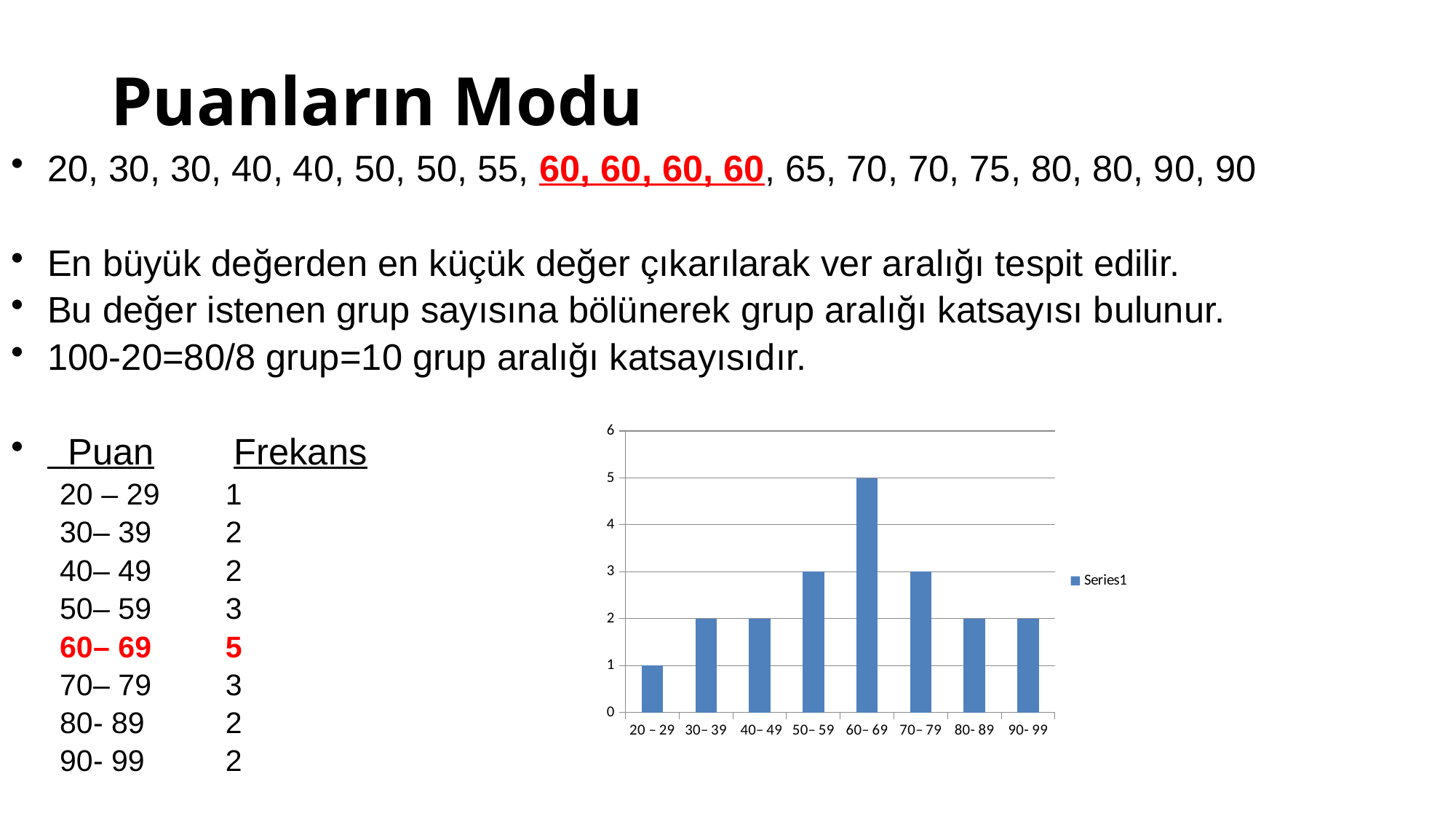
How many categories are shown on the x axis? 8 What is the value of the bar for 20 – 29? 1 What is the value of the bar for 60– 69? 5 Which category has the lowest bar? 20 – 29 Is the value for 60– 69 greater or less than 4? greater Which category has the highest bar? 60– 69 Which is larger, the value for 70– 79 or the value for 80- 89? 70– 79 What is the difference between the values for 60– 69 and 50– 59? 2 What is the name of the series shown in the legend? Series1 How many series does the legend list? 1 What is the value of the bar for 50– 59? 3 What kind of chart is shown? bar chart